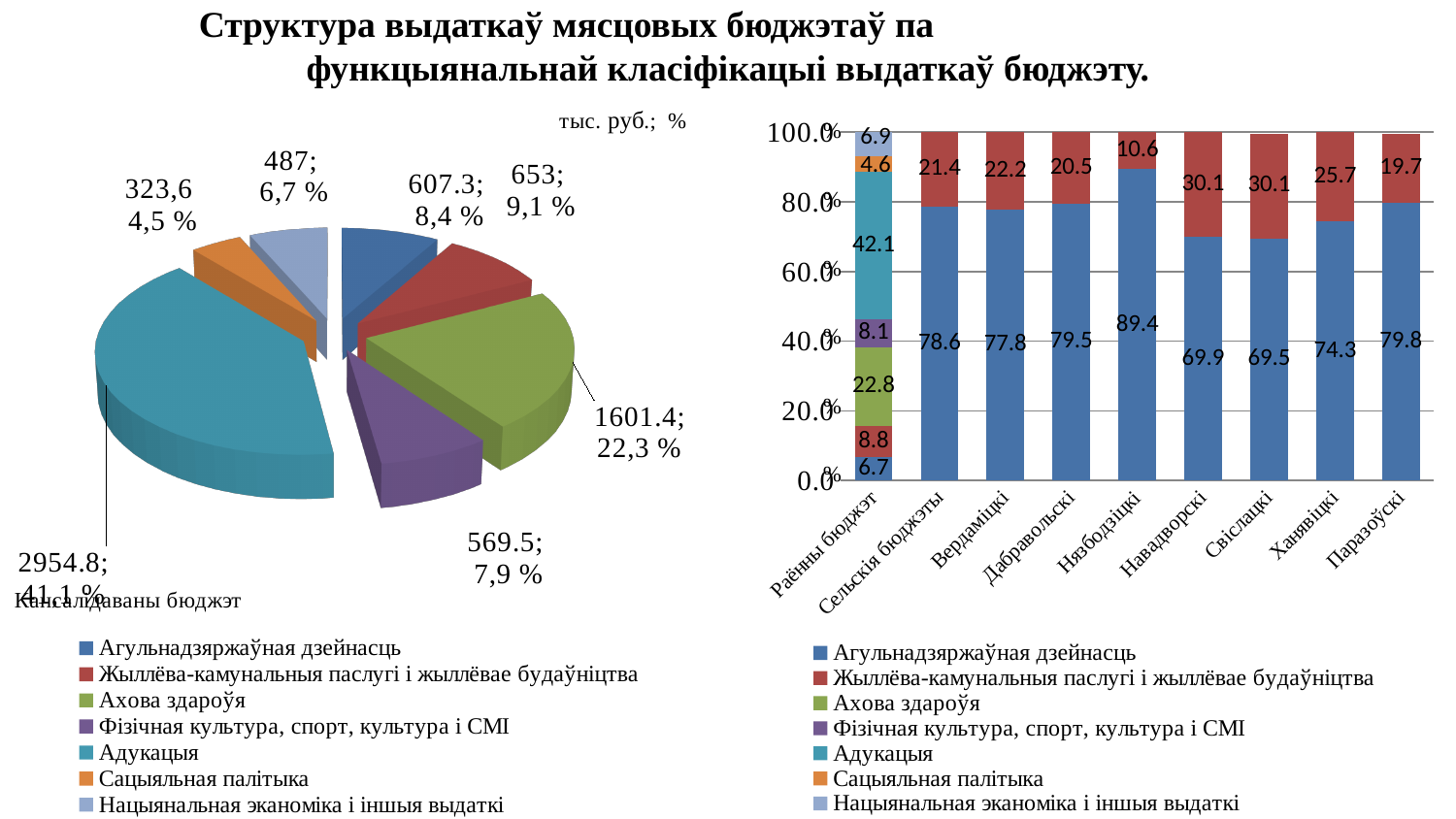
How many series does the legend of the stacked bar chart on the right list? 7 On the pie chart (Кансалідаваны бюджэт), how many slices are there? 7 On the stacked bar chart on the right, what is the value of Адукацыя for Раённы бюджэт? 42.1 On the stacked bar chart on the right, which category has the highest value for Жыллёва-камунальныя паслугі і жыллёвае будаўніцтва among the bars other than Раённы бюджэт? Навадворскі and Свіслацкі (30.1) On the pie chart (Кансалідаваны бюджэт), which category has the largest slice? Адукацыя On the pie chart (Кансалідаваны бюджэт), which category has the smallest slice? Сацыяльная палітыка On the pie chart (Кансалідаваны бюджэт), what percentage share is shown for Ахова здароўя? 22,3 % On the stacked bar chart on the right, how many categories are shown on the x axis? 9 On the stacked bar chart on the right, what is the value of Агульнадзяржаўная дзейнасць for Нябодзіцкі? 89.4 What type of chart is the chart on the left of the slide? Pie chart On the stacked bar chart on the right, what is the difference between the Агульнадзяржаўная дзейнасць values for Нябодзіцкі and Свіслацкі? 19.9 On the pie chart (Кансалідаваны бюджэт), what value is shown for Адукацыя? 2954.8; 41,1 %